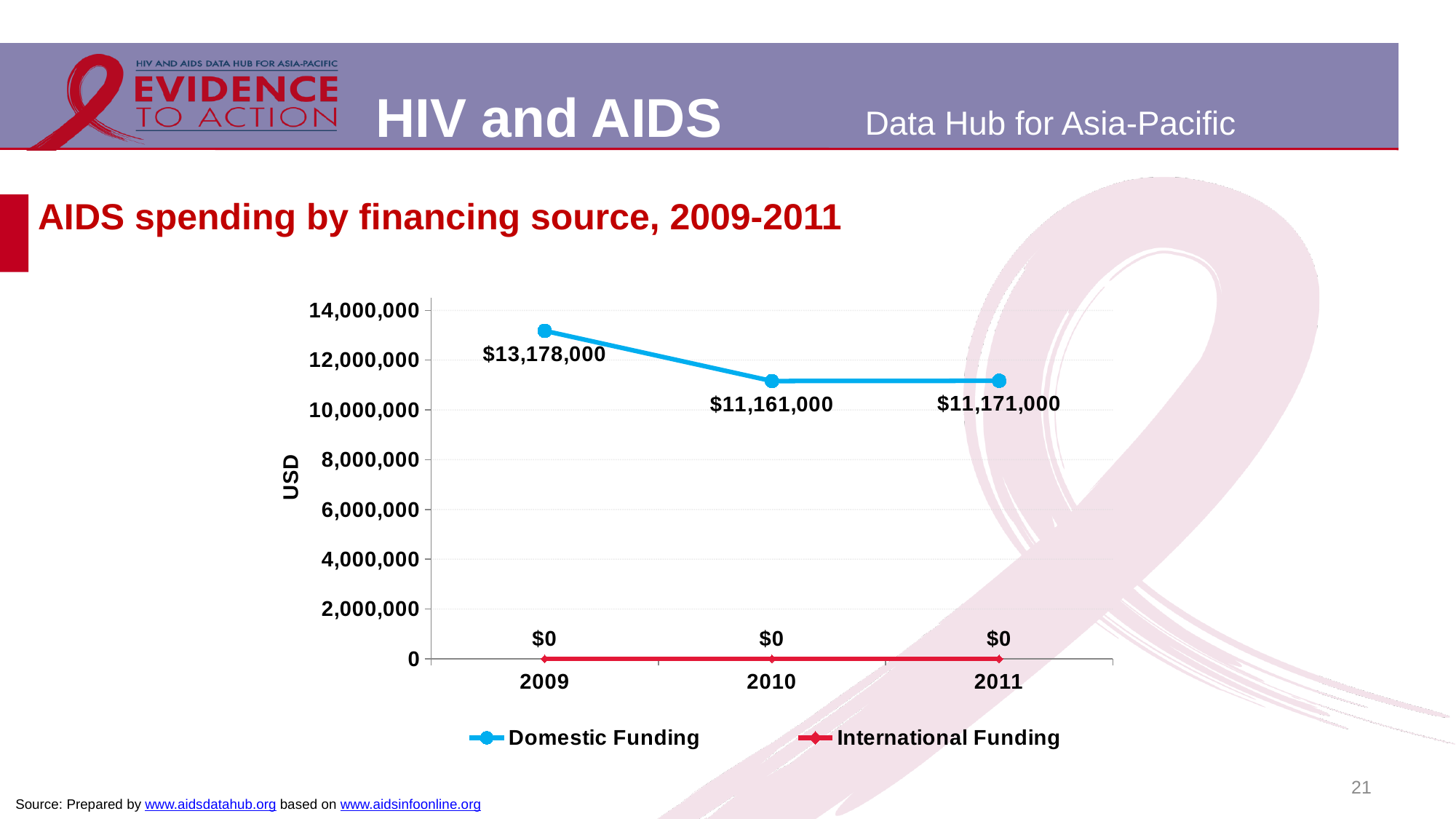
What was the Domestic Funding value in 2011? $11,171,000 How many years are shown on the x axis? 3 What is the label on the vertical axis? USD What is the difference between Domestic Funding in 2009 and 2010? $2,017,000 How many series does the legend list? 2 In which year was Domestic Funding highest? 2009 What was the International Funding value in 2010? $0 What was the Domestic Funding value in 2010? $11,161,000 What kind of chart is shown on the slide? Line chart What was the Domestic Funding value in 2009? $13,178,000 Which was larger in 2011, Domestic Funding or International Funding? Domestic Funding In which year was Domestic Funding lowest? 2010